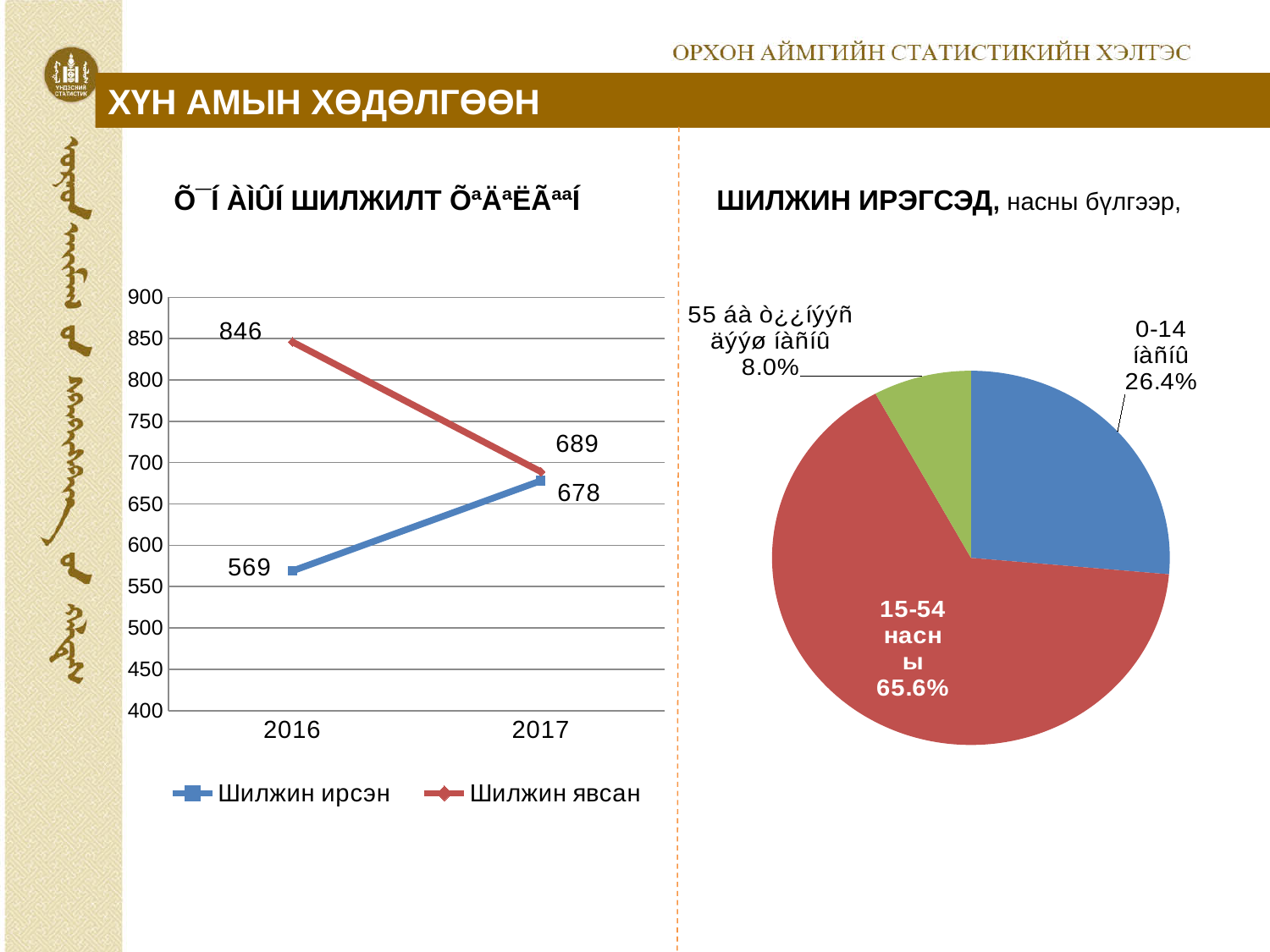
On the line chart on the left, does Шилжин ирсэн rise or fall from 2016 to 2017? rise What kind of chart is the chart on the right of the slide? pie chart On the pie chart ШИЛЖИН ИРЭГСЭД, what share does the 0-14 group have? 26.4% On the line chart on the left, how many series does the legend list? 2 On the line chart on the left, which series has the higher value in 2016? Шилжин явсан On the line chart on the left, what is the value for Шилжин явсан in 2017? 689 On the pie chart ШИЛЖИН ИРЭГСЭД, what share does the 15-54 насны group have? 65.6% On the line chart on the left, by how much did Шилжин явсан change from 2016 to 2017? 157 On the line chart on the left, what is the difference between Шилжин явсан and Шилжин ирсэн in 2016? 277 On the line chart on the left, what is the value for Шилжин явсан in 2016? 846 On the line chart on the left, what is the value for Шилжин ирсэн in 2017? 678 On the line chart on the left, what is the value for Шилжин ирсэн in 2016? 569